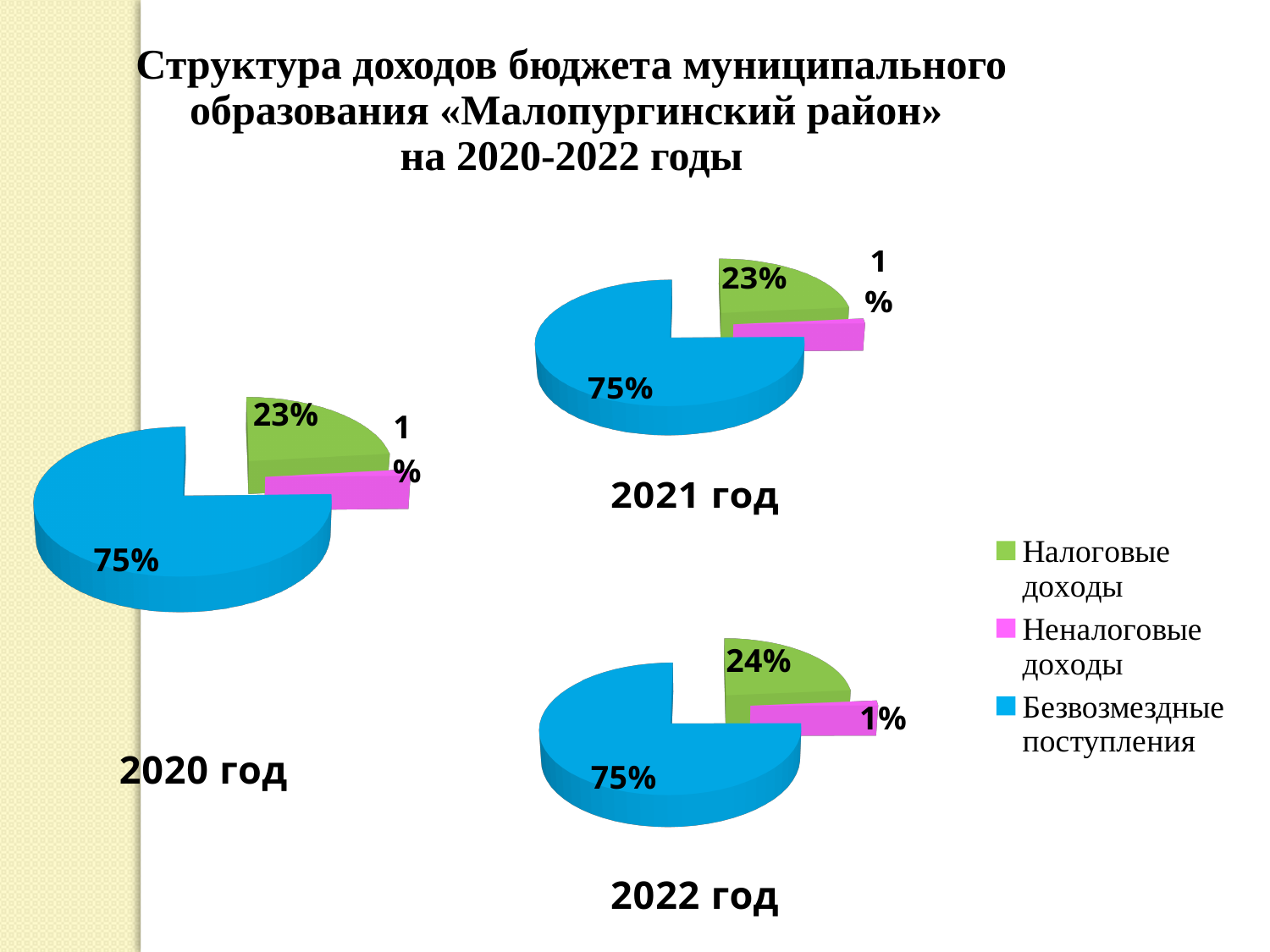
In the 2021 год pie chart, which category has the smallest slice? Неналоговые доходы How many series does the legend list? 3 In the 2020 год pie chart, what share is labelled for Безвозмездные поступления? 75% How many slices does the 2021 год pie chart have? 3 In the 2020 год pie chart, what share is labelled for Налоговые доходы? 23% In the 2022 год pie chart, what share is labelled for Налоговые доходы? 24% In the 2021 год pie chart, what share is labelled for Неналоговые доходы? 1% What kind of chart is used for 2020 год? Pie chart In the 2020 год pie chart, which is larger: Налоговые доходы or Неналоговые доходы? Налоговые доходы In the 2022 год pie chart, what is the difference between the shares of Безвозмездные поступления and Налоговые доходы? 51% In the 2022 год pie chart, which category has the largest slice? Безвозмездные поступления Which colour represents Неналоговые доходы in the legend? Pink